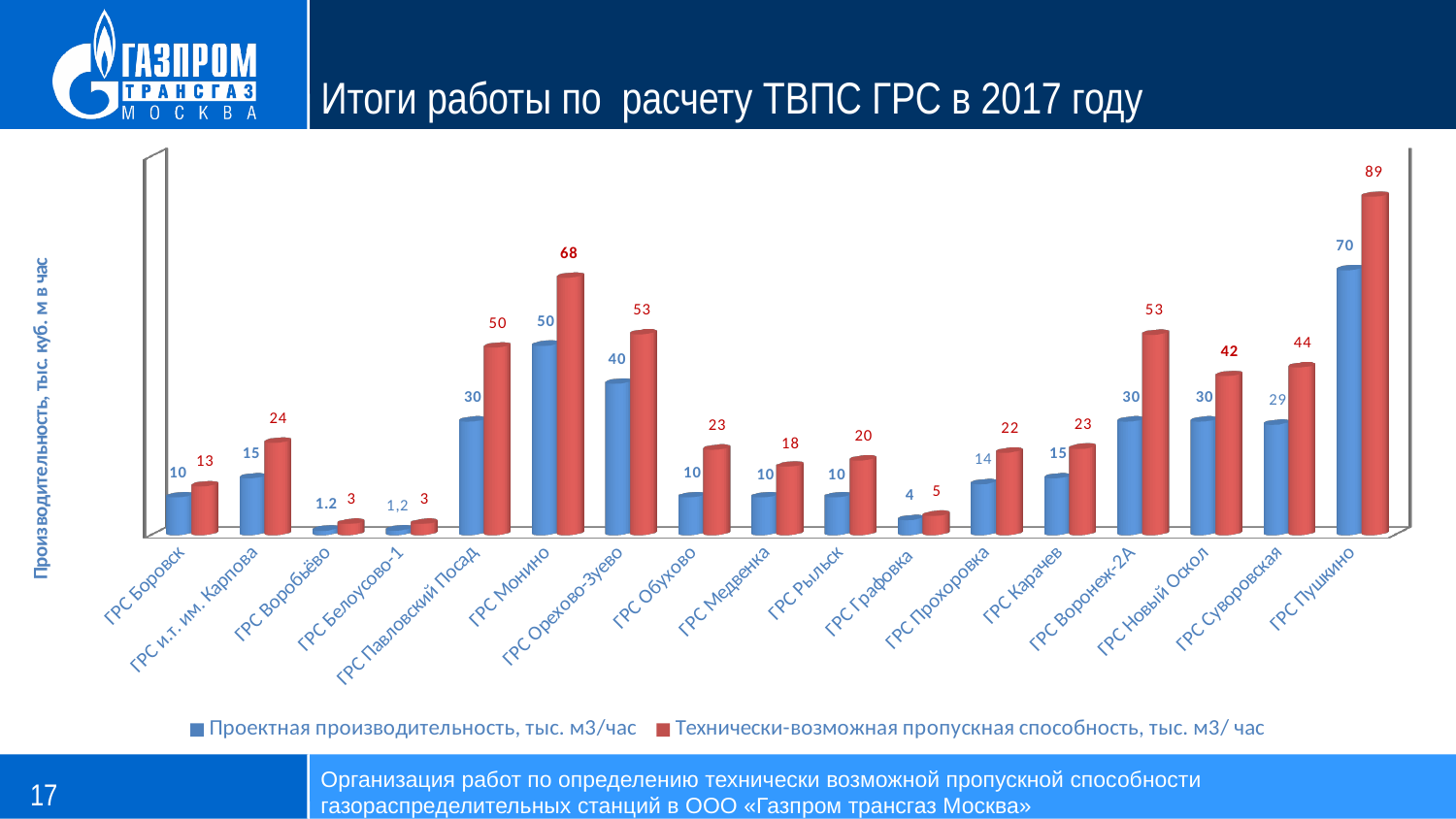
What is the Проектная производительность value for ГРС Орехово-Зуево? 40 What is the title of the chart slide? Итоги работы по расчету ТВПС ГРС в 2017 году Which station has the highest Технически-возможная пропускная способность? ГРС Пушкино What type of chart is shown on the slide? bar chart Which is larger: the Проектная производительность for ГРС Монино or for ГРС Павловский Посад? ГРС Монино How many series does the legend list? 2 What is the difference between the Технически-возможная пропускная способность and the Проектная производительность for ГРС Пушкино? 19 How many ГРС stations (categories) are shown on the x axis? 17 What is the Технически-возможная пропускная способность value for ГРС Суворовская? 44 Which station has the lowest Технически-возможная пропускная способность? ГРС Воробьёво and ГРС Белоусово-1 (both 3) What is the difference between the Технически-возможная пропускная способность and the Проектная производительность for ГРС Воронеж-2А? 23 What is the Технически-возможная пропускная способность value for ГРС Монино? 68